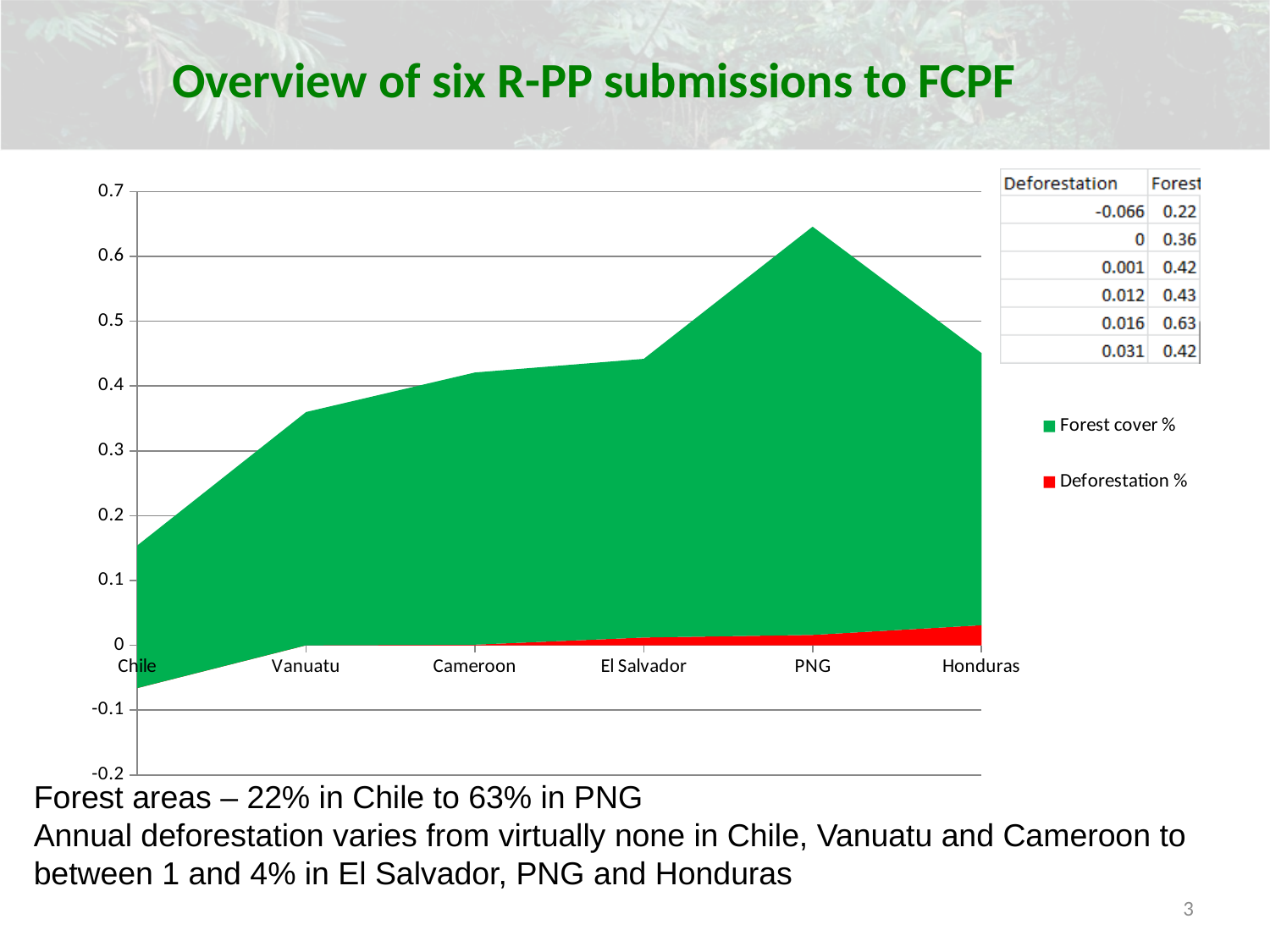
Which country has a higher Forest cover %, Vanuatu or Cameroon? Cameroon What kind of chart is shown on the slide? Area chart In the data table next to the chart, what is the highest Forest value listed? 0.63 Which country has the highest Deforestation % in the chart? Honduras Is the top of the stacked area for PNG greater or less than 0.6? greater In the data table next to the chart, what is the lowest Deforestation value listed? -0.066 Which country has the highest Forest cover % in the chart? PNG Which colour represents Forest cover % in the chart? Green How many series does the chart legend list? 2 How many countries are shown along the x axis of the chart? 6 Which country has the lowest Forest cover % in the chart? Chile Is the top of the stacked area for Chile greater or less than 0.2? less